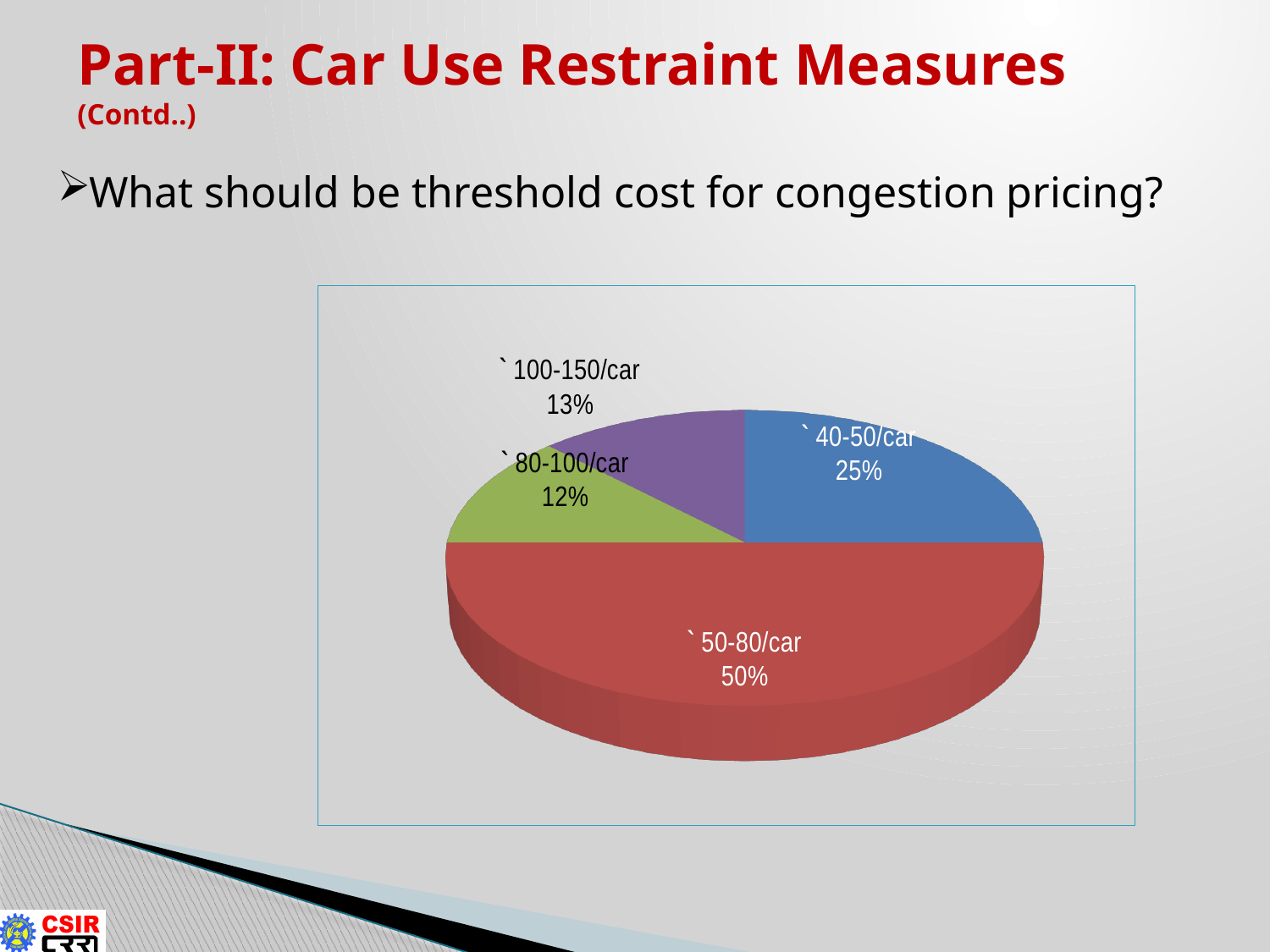
How many slices does the pie chart have? 4 Which threshold cost category has the largest share of the pie? 50-80/car What share of the pie does the 50-80/car slice represent? 50% What colour is the 50-80/car slice in the pie chart? red What is the combined share of the 80-100/car and 100-150/car slices? 25% What kind of chart is shown on the slide? pie chart Which threshold cost category has the smallest share of the pie? 80-100/car What share of the pie does the 80-100/car slice represent? 12% Which slice is larger, 40-50/car or 100-150/car? 40-50/car What share of the pie does the 40-50/car slice represent? 25% What is the difference in percentage points between the 50-80/car slice and the 40-50/car slice? 25